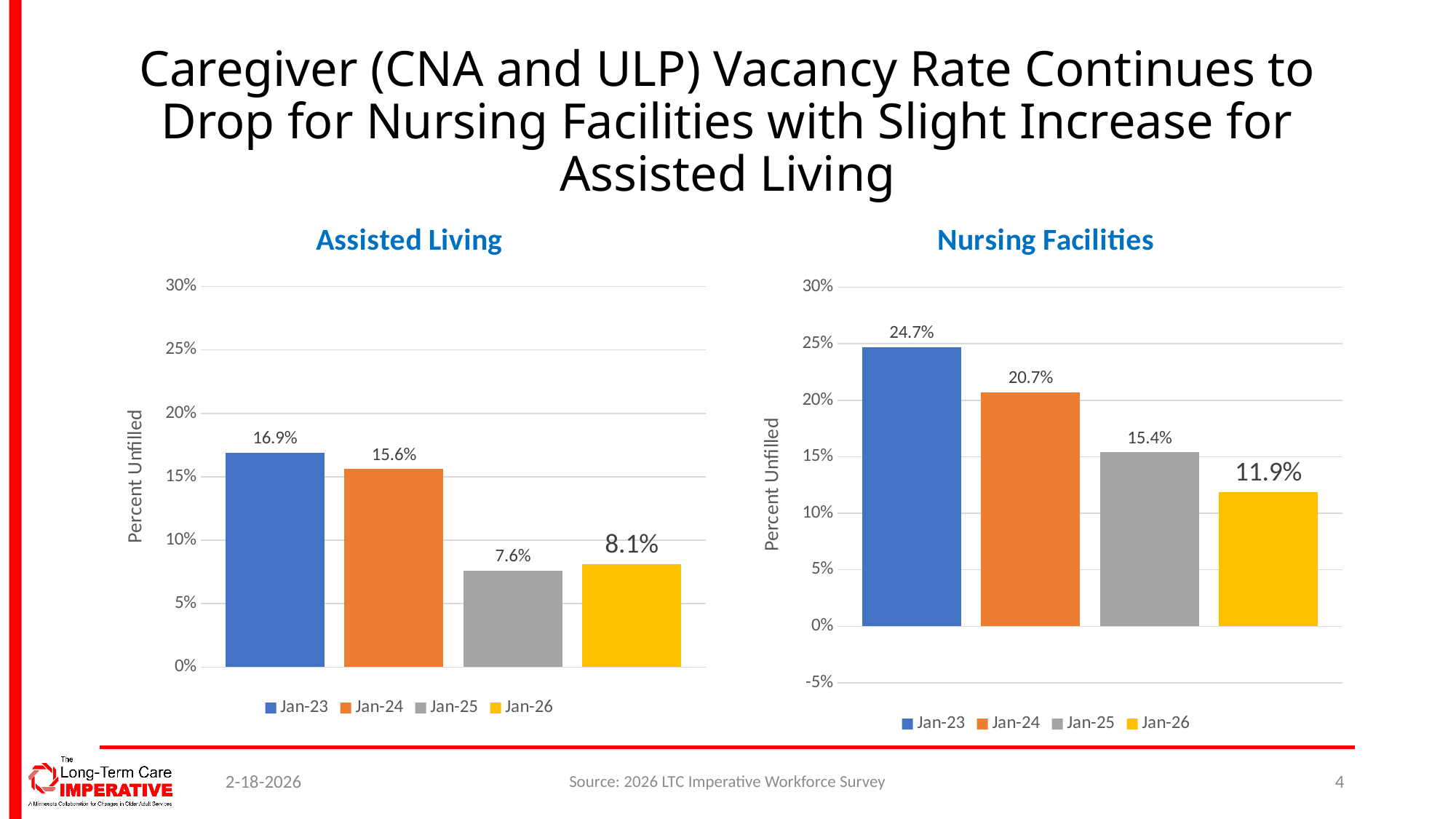
In the Assisted Living chart, which is larger, the value for Jan-25 or the value for Jan-26? Jan-26 In the Nursing Facilities chart, which year has the highest value? Jan-23 In the Assisted Living chart, what is the value for Jan-23? 16.9% In the Nursing Facilities chart, do the values rise or fall from Jan-23 to Jan-26? Fall In the Nursing Facilities chart, what is the value for Jan-26? 11.9% In the Assisted Living chart, what is the difference between the Jan-24 and Jan-25 values? 8.0% In the Assisted Living chart, what is the value for Jan-25? 7.6% In the Nursing Facilities chart, what is the difference between the Jan-23 and Jan-26 values? 12.8% In the Assisted Living chart, which year has the lowest value? Jan-25 What kind of chart is the Assisted Living chart? Bar chart How many series does the legend of the Nursing Facilities chart list? 4 In the Nursing Facilities chart, is the value for Jan-24 greater or less than 20%? greater